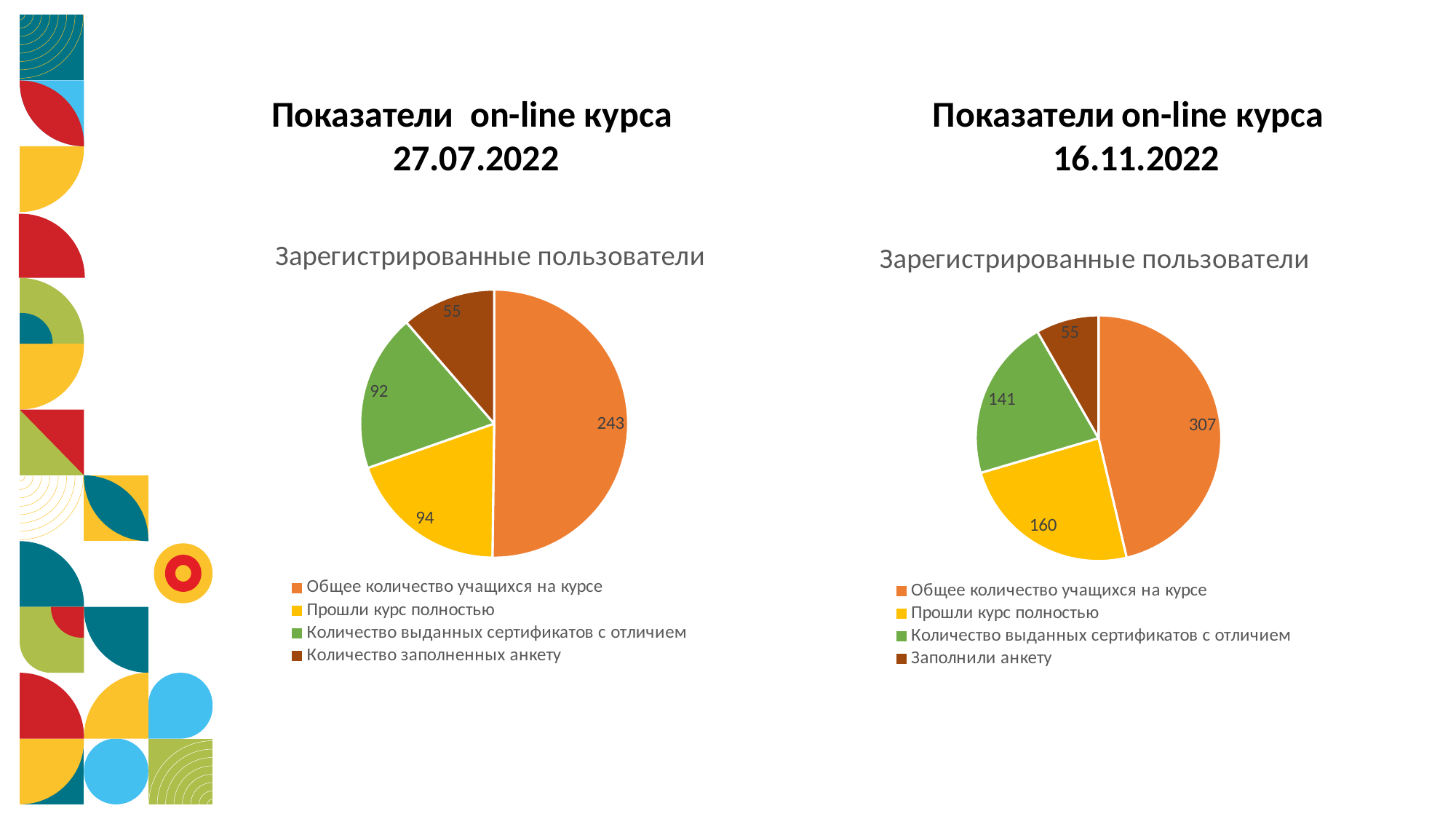
What is the difference between Общее количество учащихся на курсе in the right chart (16.11.2022) and in the left chart (27.07.2022)? 64 In the right pie chart (16.11.2022), what is the value for Прошли курс полностью? 160 In the right pie chart (16.11.2022), which category has the smallest slice? Заполнили анкету What type of chart is used on the right side of the slide (16.11.2022)? Pie chart Which is larger: Прошли курс полностью in the left chart (27.07.2022) or in the right chart (16.11.2022)? Right chart (16.11.2022) In the left pie chart (27.07.2022), what is the value for Общее количество учащихся на курсе? 243 In the left pie chart (27.07.2022), what is the value for Количество заполненных анкету? 55 In the right pie chart (16.11.2022), what is the difference between Прошли курс полностью and Количество выданных сертификатов с отличием? 19 How many slices does the left pie chart (27.07.2022) have? 4 What is the title of the left chart (27.07.2022)? Зарегистрированные пользователи In the right pie chart (16.11.2022), what is the value for Количество выданных сертификатов с отличием? 141 In the left pie chart (27.07.2022), which category has the largest slice? Общее количество учащихся на курсе